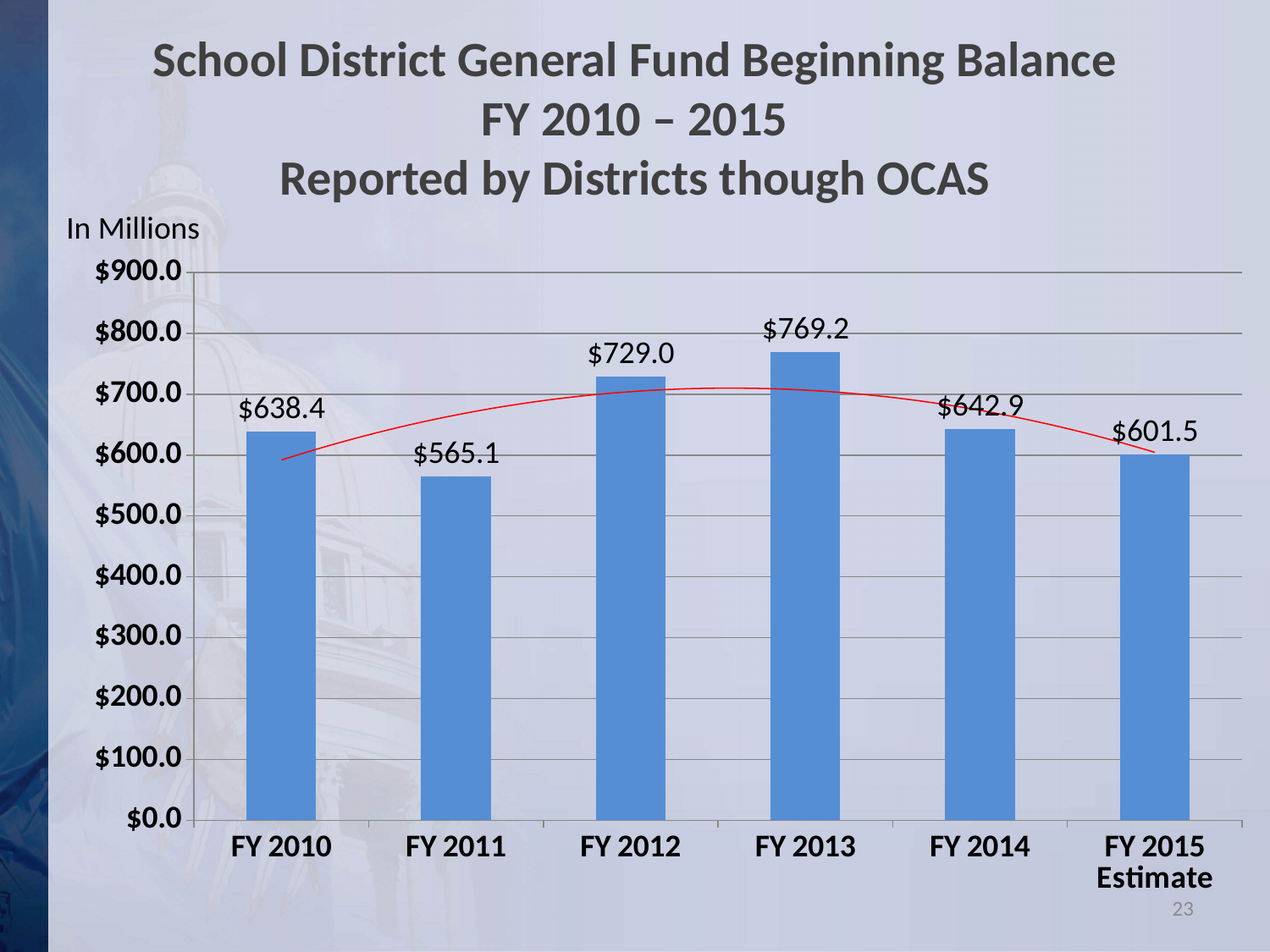
How many fiscal years are shown on the x axis? 6 What is the value shown for FY 2011? $565.1 Is the value for FY 2013 greater or less than $700.0? greater What is the difference between the FY 2010 and FY 2011 values? $73.3 Which fiscal year has the lowest beginning balance? FY 2011 What is the difference between the FY 2013 and FY 2012 values? $40.2 What is the value shown for FY 2015 Estimate? $601.5 Which is larger, the value for FY 2010 or the value for FY 2014? FY 2014 Which fiscal year has the highest beginning balance? FY 2013 In what units are the values on the chart expressed? In Millions What kind of chart is shown on the slide? Bar chart What is the general fund beginning balance for FY 2012? $729.0